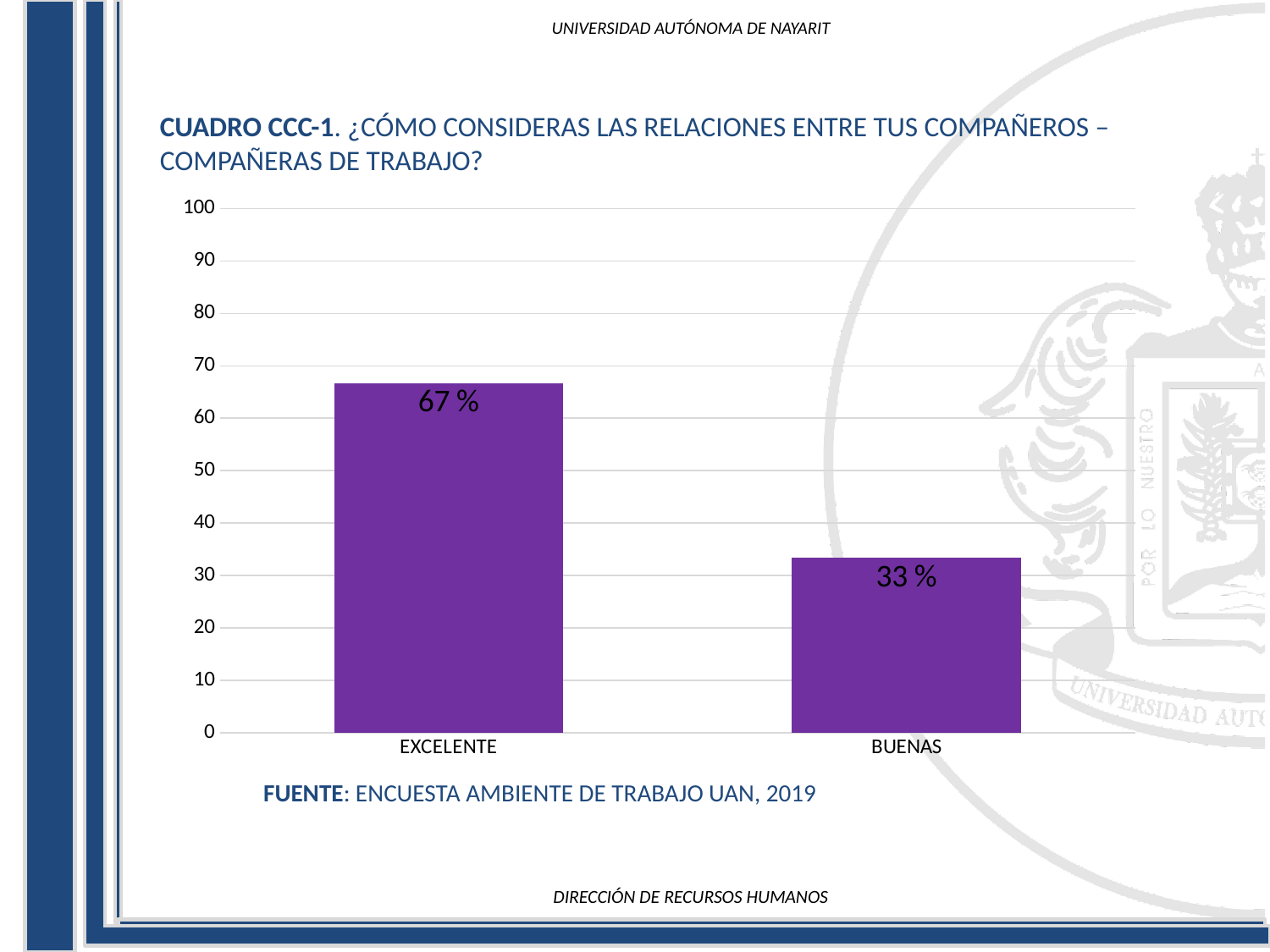
What is the maximum value shown on the y axis? 100 What is the difference between the values for EXCELENTE and BUENAS? 34 % How many categories are shown on the x axis? 2 Is the value for BUENAS greater or less than 40? less What source is cited below the chart? ENCUESTA AMBIENTE DE TRABAJO UAN, 2019 Which category has the lowest value? BUENAS What kind of chart is shown on the slide? bar chart Which category has the highest value? EXCELENTE Which is larger, the value for EXCELENTE or the value for BUENAS? EXCELENTE What is the value for EXCELENTE? 67 % Is the value for EXCELENTE greater or less than 60? greater What is the value for BUENAS? 33 %